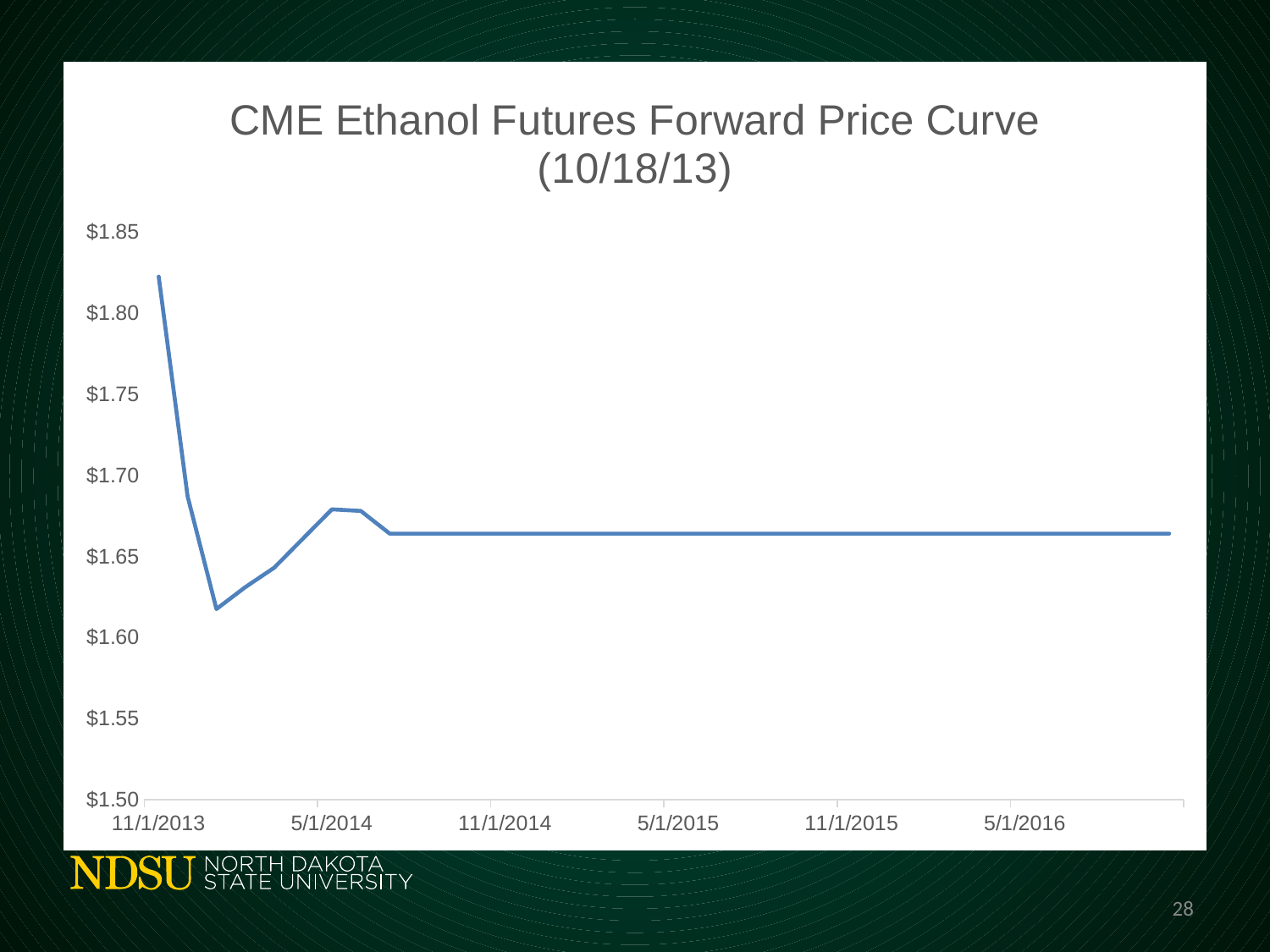
What kind of chart is shown on the slide? line chart Which is larger, the value at 11/1/2013 or the value at 5/1/2014? 11/1/2013 Is the value at 11/1/2015 greater or less than $1.65? greater Between 11/1/2014 and 5/1/2016, does the curve rise, fall, or stay flat? stay flat Overall, do the values rise or fall from 11/1/2013 to 5/1/2016? fall Is the value at 11/1/2013 greater or less than $1.80? greater Is the value at 5/1/2016 greater or less than $1.60? greater What is the title of the chart? CME Ethanol Futures Forward Price Curve (10/18/13) Which date on the x axis has the highest value on the curve? 11/1/2013 What is the highest value shown on the y axis? $1.85